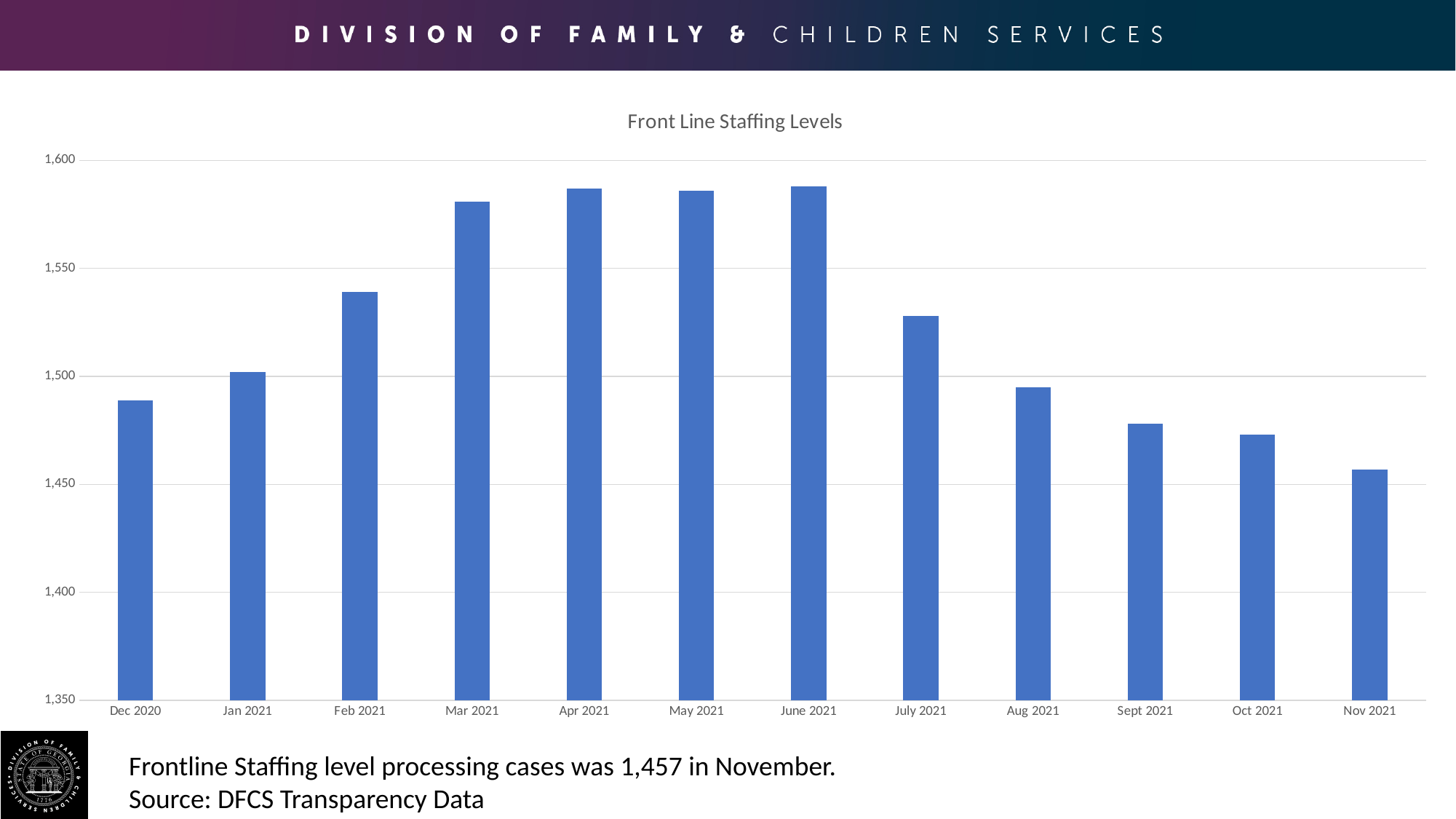
Which is larger, the value for Mar 2021 or the value for July 2021? Mar 2021 Do the staffing levels rise or fall from June 2021 to Nov 2021? fall What was the front line staffing level in Nov 2021? 1,457 Is the value for Mar 2021 greater or less than 1,550? greater Is the value for Aug 2021 greater or less than 1,500? less Is the value for Dec 2020 greater or less than 1,500? less Which is larger, the value for Feb 2021 or the value for Jan 2021? Feb 2021 Which month has the lowest front line staffing level? Nov 2021 How many months are plotted on the chart? 12 What type of chart is shown on the slide? bar chart What is the title of the chart? Front Line Staffing Levels